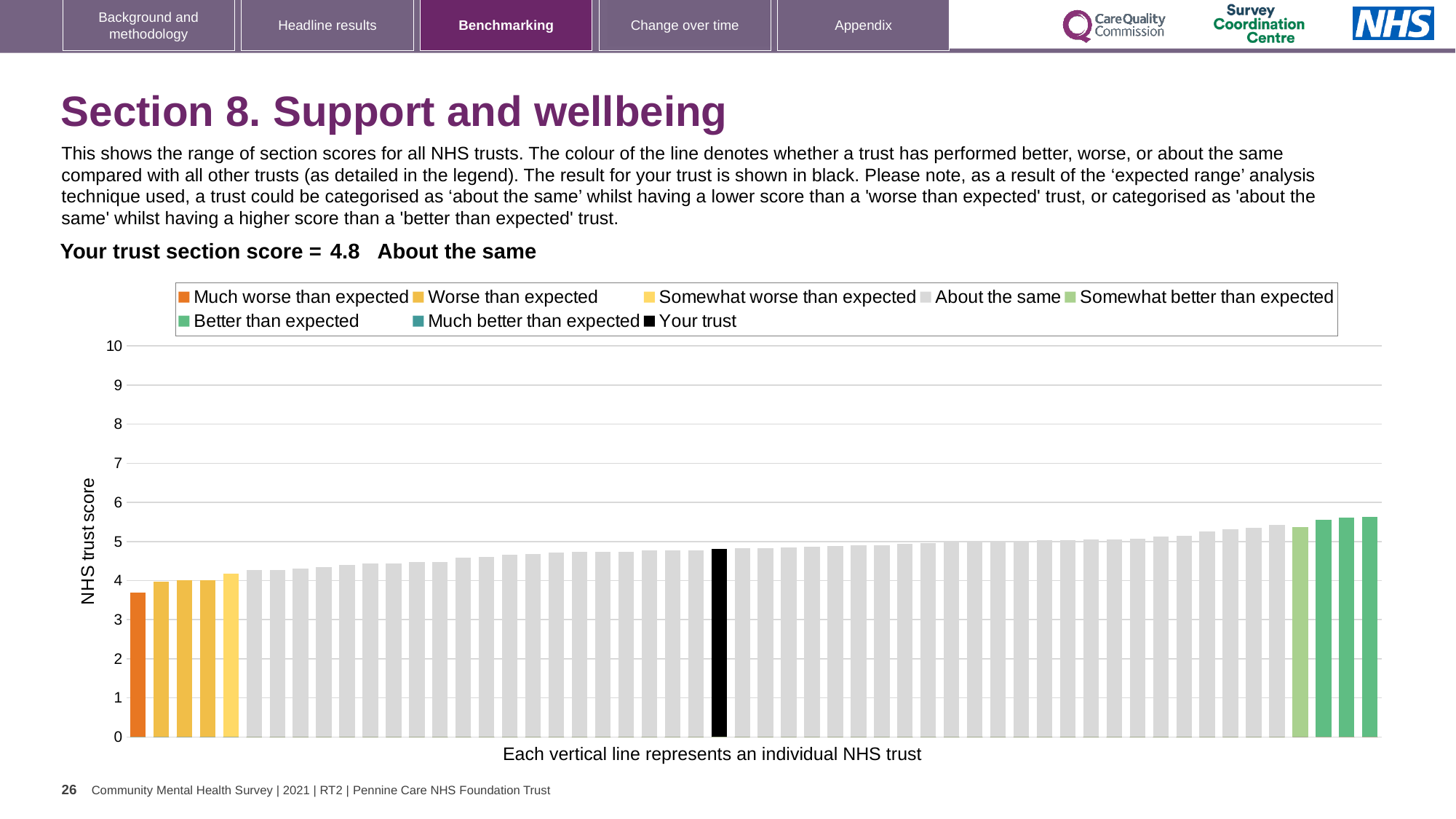
Which is taller: the black 'Your trust' bar or the orange 'Much worse than expected' bar? The black 'Your trust' bar Is the value of the tallest bar greater or less than 6? less Which legend category does the tallest bar on the chart belong to? Better than expected How is your trust's section score categorised compared with other trusts? About the same What is the label on the vertical axis of the chart? NHS trust score Is the value of the black 'Your trust' bar greater or less than 4? greater How many entries does the chart legend list? 8 Is the value of the orange 'Much worse than expected' bar greater or less than 4? less Do the trust scores rise or fall from left to right along the x axis? Rise What is the section score for your trust shown on the slide? 4.8 Which legend category does the shortest bar on the chart belong to? Much worse than expected What kind of chart is shown on the slide? Bar chart